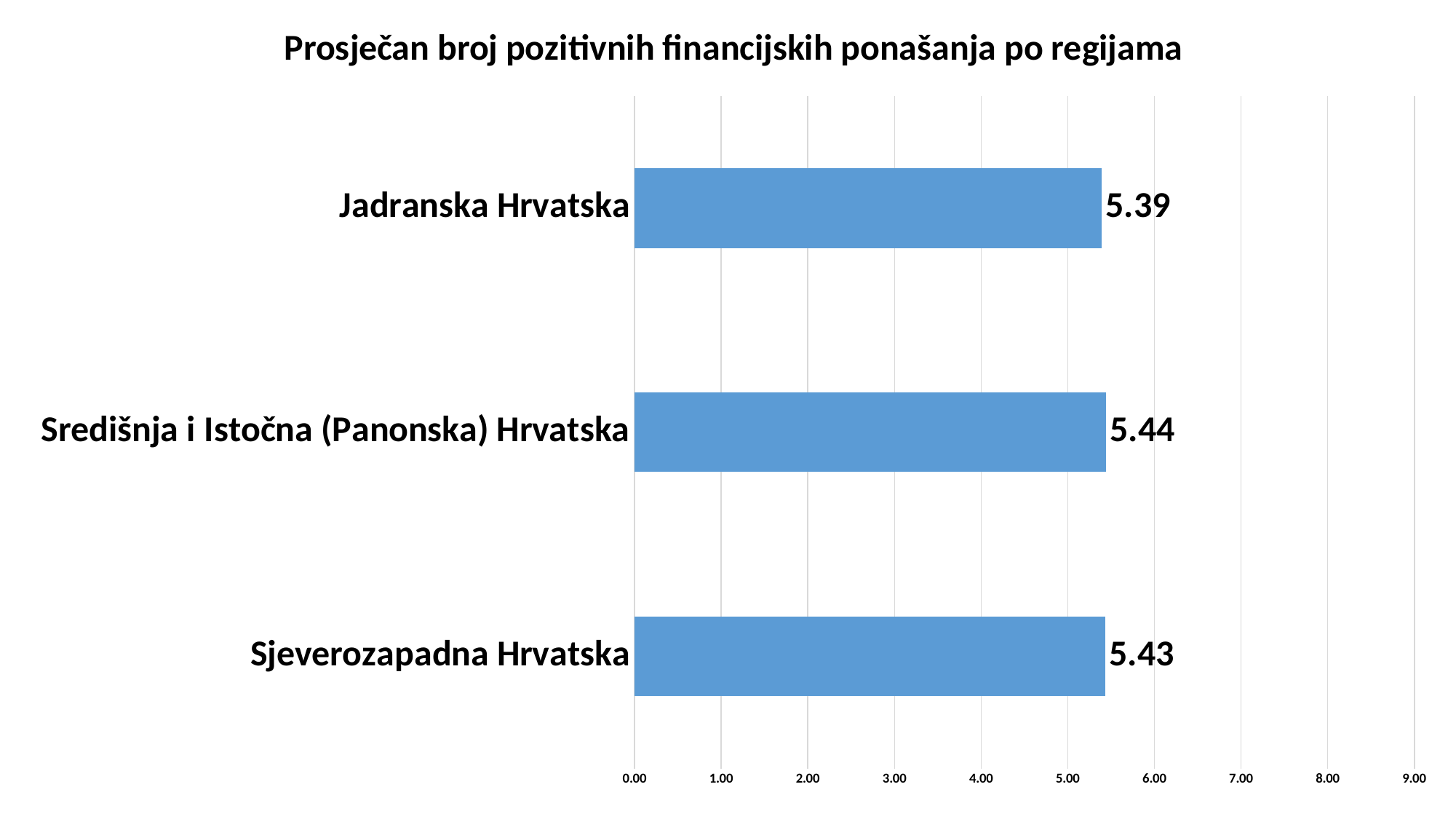
What is the value for Središnja i Istočna (Panonska) Hrvatska? 5.44 What is the difference between the values for Sjeverozapadna Hrvatska and Jadranska Hrvatska? 0.04 What is the value for Jadranska Hrvatska? 5.39 What is the title of the chart? Prosječan broj pozitivnih financijskih ponašanja po regijama Which is larger, the value for Sjeverozapadna Hrvatska or the value for Jadranska Hrvatska? Sjeverozapadna Hrvatska Is the value for Jadranska Hrvatska greater or less than 5.00? greater What is the value for Sjeverozapadna Hrvatska? 5.43 Which region has the lowest value? Jadranska Hrvatska What kind of chart is shown on the slide? bar chart What is the difference between the values for Središnja i Istočna (Panonska) Hrvatska and Jadranska Hrvatska? 0.05 Which region has the highest value? Središnja i Istočna (Panonska) Hrvatska How many regions are shown in the chart? 3